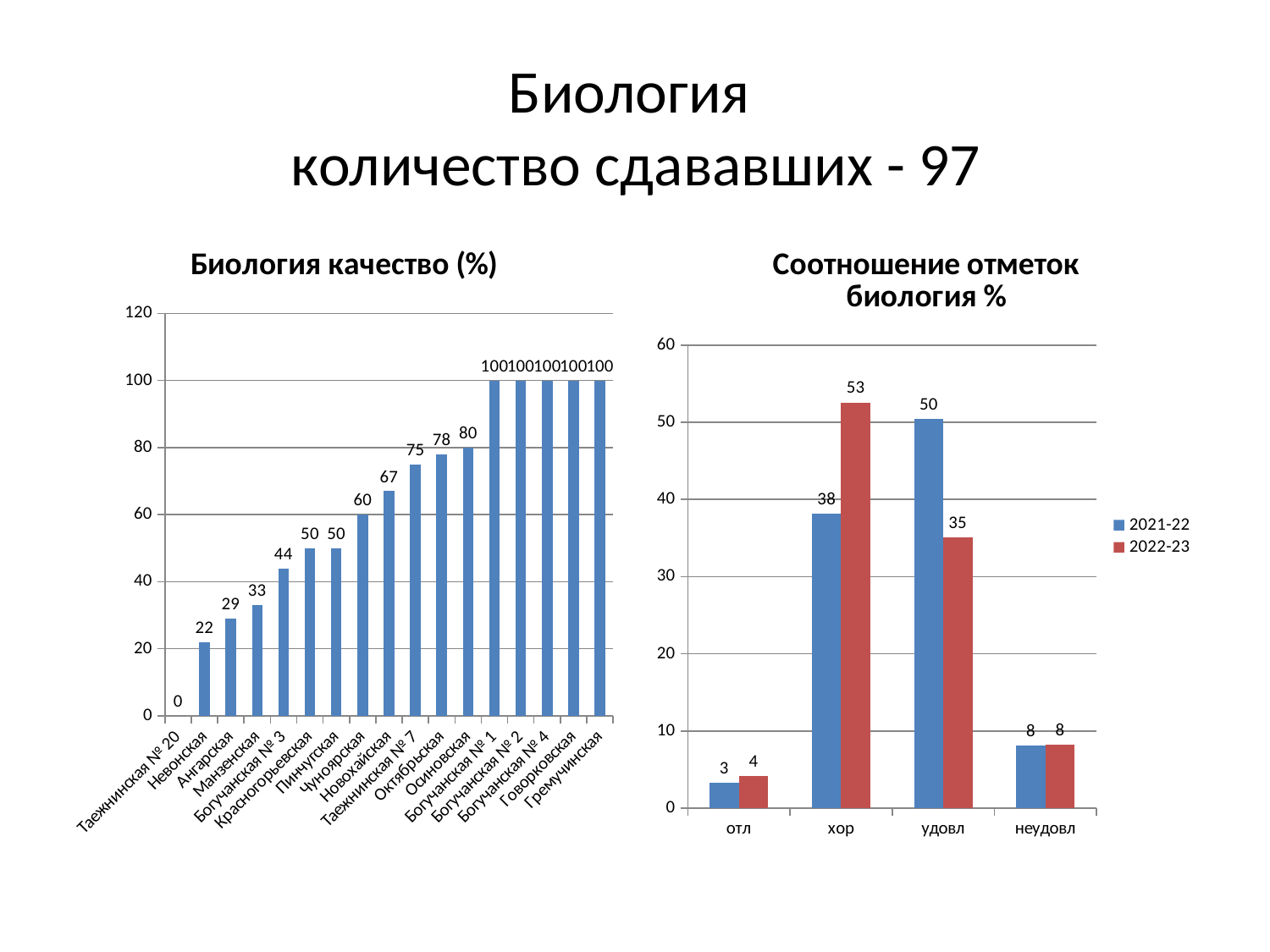
In the chart 'Биология качество (%)', do the values rise or fall from left to right along the x axis? rise In the chart 'Биология качество (%)', what is the difference between the values for Осиновская and Чуноярская? 20 In the chart 'Соотношение отметок биология %', which is larger for удовл: the 2021-22 value or the 2022-23 value? 2021-22 In the chart 'Соотношение отметок биология %', what is the difference between the 2022-23 and 2021-22 values for хор? 15 In the chart 'Биология качество (%)', how many categories are shown on the x axis? 17 In the chart 'Соотношение отметок биология %', how many series does the legend list? 2 What kind of chart is 'Соотношение отметок биология %'? bar chart In the chart 'Биология качество (%)', what is the value for Новохайская? 67 In the chart 'Биология качество (%)', which category has the lowest value? Таежнинская № 20 In the chart 'Биология качество (%)', what is the value for Невонская? 22 In the chart 'Соотношение отметок биология %', what is the value for хор in the 2022-23 series? 53 In the chart 'Соотношение отметок биология %', what is the value for удовл in the 2021-22 series? 50